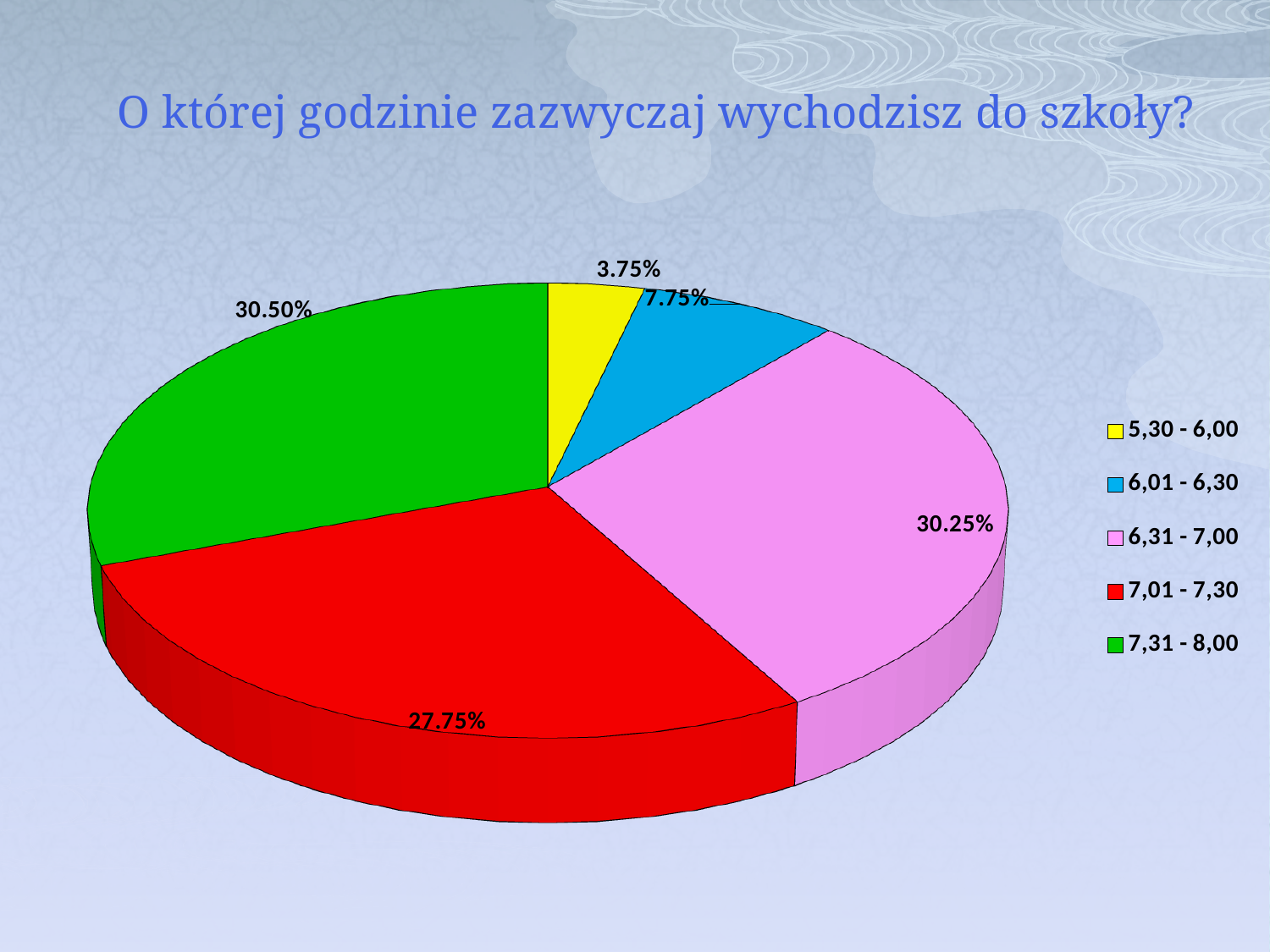
What is the value for 7,01 - 7,30? 27.75% How many categories does the pie chart have? 5 Which category has the smallest slice? 5,30 - 6,00 What colour is the slice for 7,01 - 7,30? red What is the value for 6,31 - 7,00? 30.25% What is the title of the chart? O której godzinie zazwyczaj wychodzisz do szkoły? What is the value for 6,01 - 6,30? 7.75% What is the value for 7,31 - 8,00? 30.50% What share of the pie does the 5,30 - 6,00 slice represent? 3.75% What kind of chart is shown on the slide? pie chart Which is larger, the slice for 6,31 - 7,00 or the slice for 7,01 - 7,30? 6,31 - 7,00 What is the difference between the values for 7,31 - 8,00 and 5,30 - 6,00? 26.75%